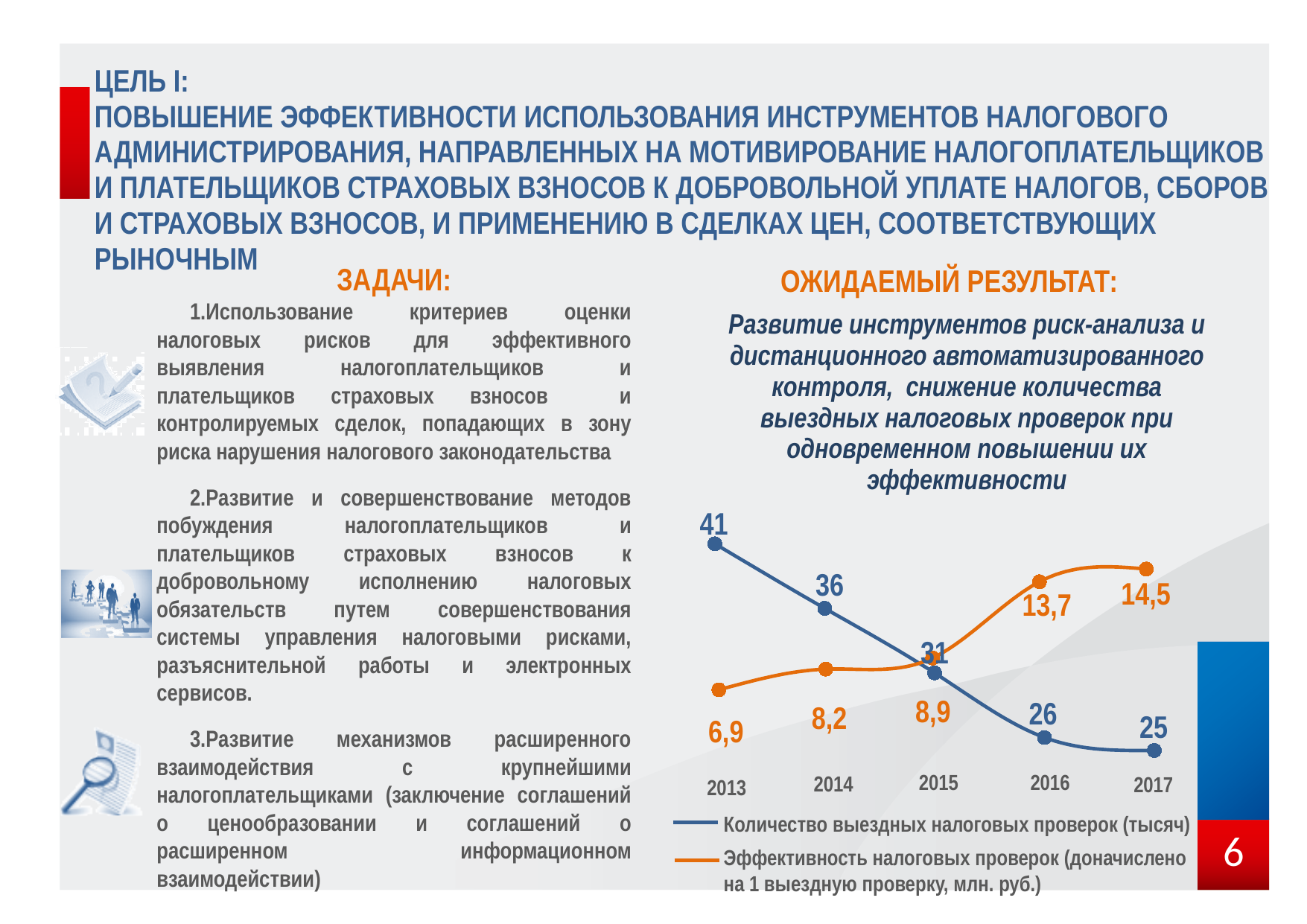
In which year is 'Количество выездных налоговых проверок (тысяч)' lowest? 2017 Which is larger: 'Эффективность налоговых проверок' in 2014 or in 2015? 2015 Which colour is used for the 'Эффективность налоговых проверок' line? orange Does 'Количество выездных налоговых проверок (тысяч)' rise or fall from 2013 to 2017? fall What is the value of 'Количество выездных налоговых проверок (тысяч)' in 2017? 25 What is the value of 'Эффективность налоговых проверок' in 2016? 13,7 How many years are plotted on the x axis of the chart? 5 In which year is 'Эффективность налоговых проверок' highest? 2017 What is the difference between the 'Количество выездных налоговых проверок (тысяч)' values for 2013 and 2017? 16 What is the value of 'Количество выездных налоговых проверок (тысяч)' in 2013? 41 How many series does the chart legend list? 2 What type of chart is shown on the slide? line chart